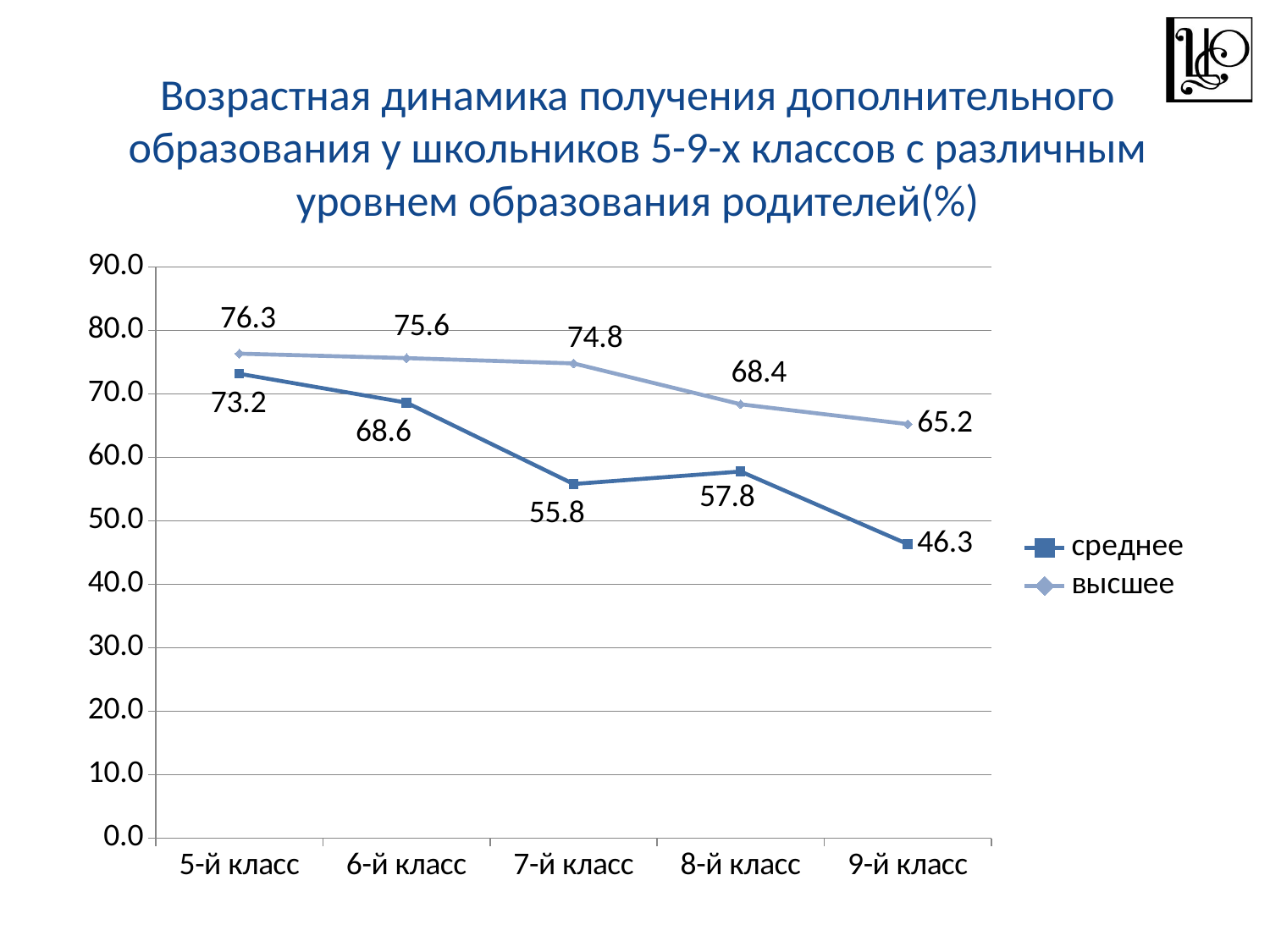
How many series does the legend list? 2 What is the value for "высшее" at 9-й класс? 65.2 Do the values of the "высшее" series rise or fall from 5-й класс to 9-й класс? fall Which is larger at 8-й класс: "среднее" or "высшее"? высшее How many classes are shown on the x axis? 5 At which class is the "среднее" series lowest? 9-й класс What is the difference between the "среднее" values at 6-й класс and 7-й класс? 12.8 What is the value for "высшее" at 5-й класс? 76.3 What is the difference between "высшее" and "среднее" at 9-й класс? 18.9 What is the value for "среднее" at 7-й класс? 55.8 At which class is the "высшее" series highest? 5-й класс What kind of chart is shown on the slide? line chart